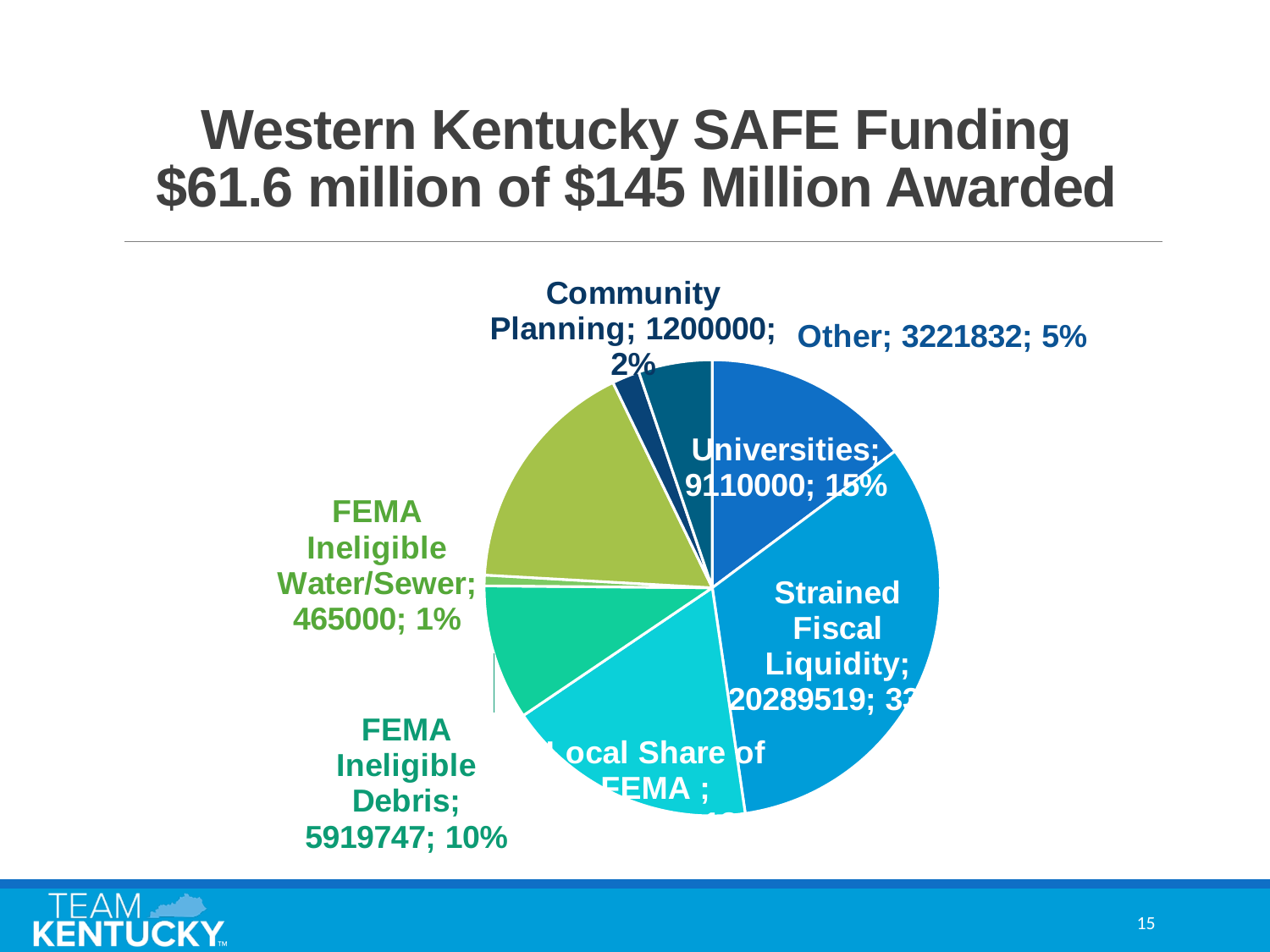
What is the difference between the values for Universities and Community Planning? 7910000 What is the value shown for FEMA Ineligible Debris? 5919747 What is the value shown for Strained Fiscal Liquidity? 20289519 Which is larger, Universities or FEMA Ineligible Debris? Universities Which category has the largest slice of the pie? Strained Fiscal Liquidity What percentage share does Other have? 5% What percentage share does Universities have in the pie chart? 15% What is the difference between the values for FEMA Ineligible Debris and Other? 2697915 What is the value shown for Universities? 9110000 What type of chart is shown on the slide? Pie chart What is the value shown for Community Planning? 1200000 What percentage share does FEMA Ineligible Water/Sewer have? 1%